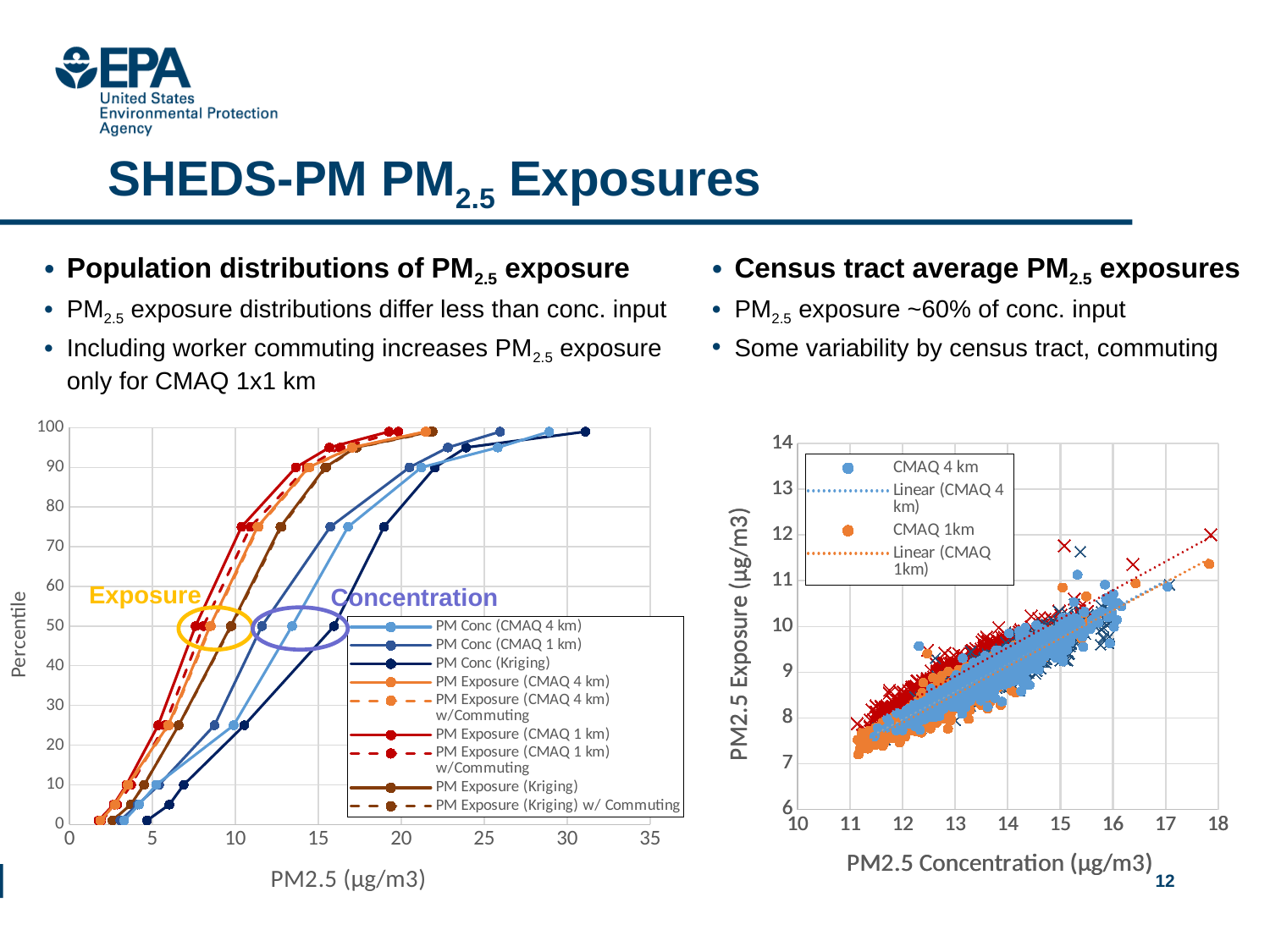
In the left chart, at the 75th percentile, which has the larger PM2.5 value: PM Conc (CMAQ 1 km) or PM Exposure (CMAQ 4 km)? PM Conc (CMAQ 1 km) What is the title of the y axis of the left chart? Percentile What kind of chart is the chart on the right of the slide? scatter chart How many entries does the legend of the right chart list? 4 How many series does the legend of the left chart list? 9 In the left chart, is the PM2.5 value for PM Conc (CMAQ 4 km) at the 50th percentile greater or less than 10? greater What is the title of the y axis of the right chart? PM2.5 Exposure (µg/m3) What kind of chart is the chart on the left of the slide? line chart In the left chart, does the percentile rise or fall as PM2.5 increases along the x axis? rise In the left chart, at the 50th percentile, which has the larger PM2.5 value: PM Conc (Kriging) or PM Exposure (Kriging)? PM Conc (Kriging) In the left chart, is the PM2.5 value for PM Exposure (CMAQ 1 km) at the 50th percentile greater or less than 10? less In the right chart, does PM2.5 exposure rise or fall as PM2.5 concentration increases along the x axis? rise